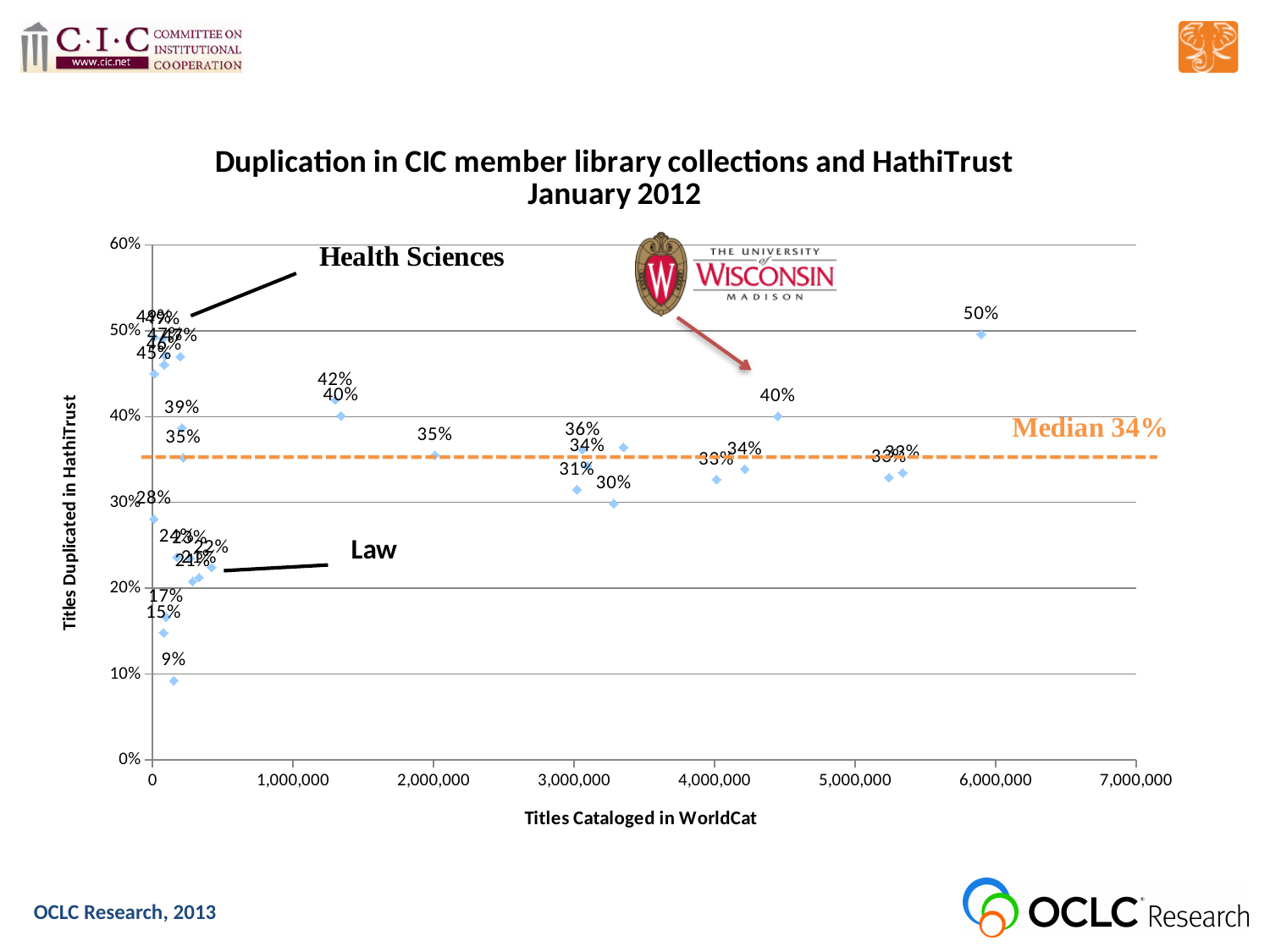
Is the point labeled 9% greater or less than 10% on the y axis? less Is the value of the rightmost point on the chart (near 6,000,000 titles) greater or less than 40%? greater What kind of chart is shown on the slide? Scatter chart What is the title of the chart? Duplication in CIC member library collections and HathiTrust January 2012 What is the label of the x axis? Titles Cataloged in WorldCat What is the highest percentage of titles duplicated in HathiTrust shown on the chart? 50% Which is larger: the value of the rightmost point on the chart or the value of the point the University of Wisconsin arrow points to? The rightmost point (50%) What is the difference between the highest labeled value (50%) and the lowest labeled value (9%) on the chart? 41 percentage points Which annotated group has lower duplication in HathiTrust, Health Sciences or Law? Law What is the lowest percentage of titles duplicated in HathiTrust shown on the chart? 9% What median value is marked by the dashed line on the chart? 34% What percentage of titles duplicated in HathiTrust is shown for the point the University of Wisconsin arrow points to? 40%